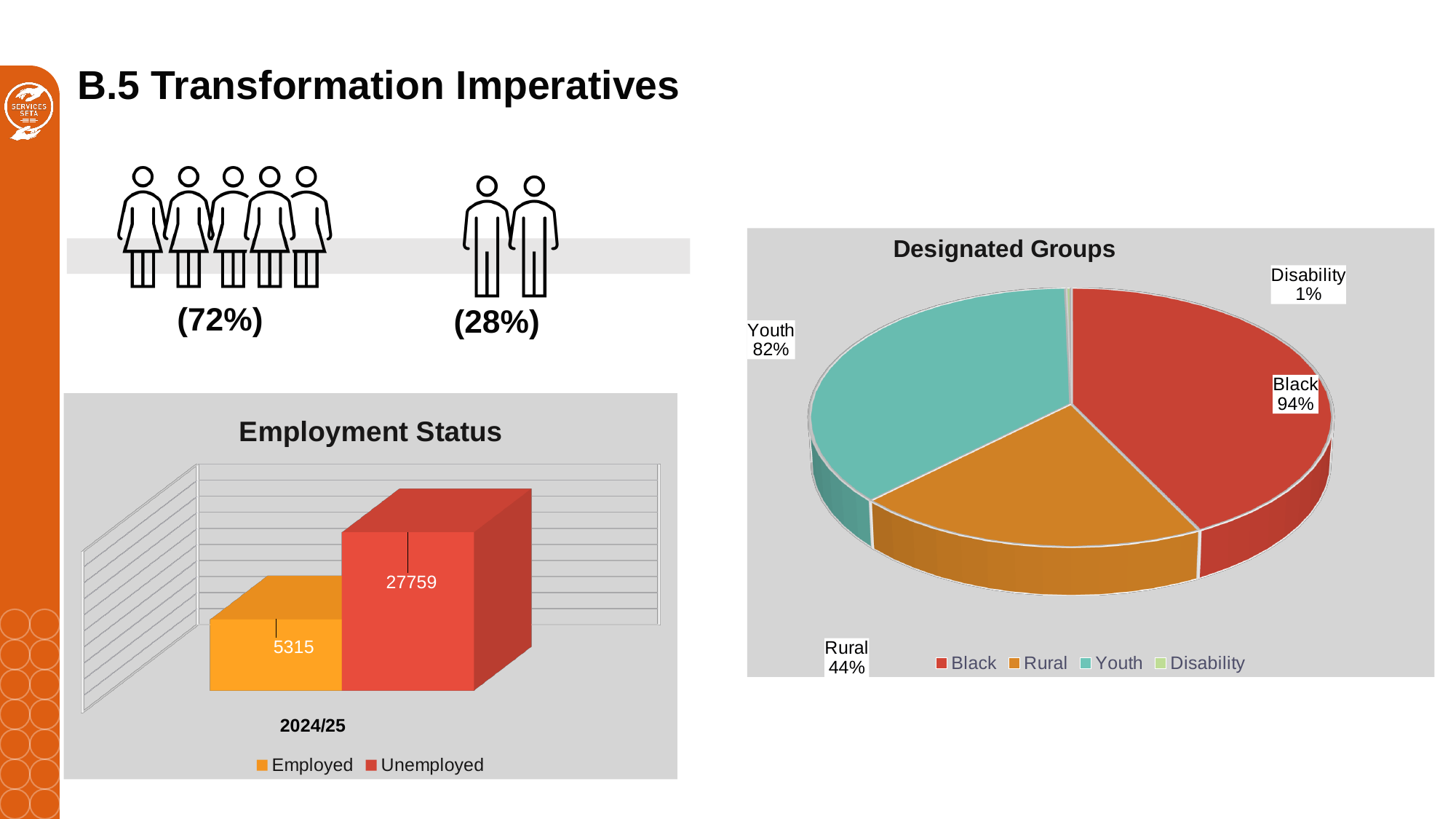
What kind of chart is the Designated Groups chart? Pie chart In the Employment Status chart, which series has the higher value, Employed or Unemployed? Unemployed In the Employment Status chart, what is the difference between the Unemployed and Employed values? 22444 In the Designated Groups chart, which group has the lowest percentage? Disability In the Employment Status chart, what is the value for Employed in 2024/25? 5315 How many categories does the legend of the Designated Groups chart list? 4 In the Designated Groups chart, what percentage is shown for Rural? 44% What kind of chart is the Employment Status chart? Bar chart In the Employment Status chart, what is the value for Unemployed in 2024/25? 27759 In the Designated Groups chart, what percentage is shown for Youth? 82% How many series does the legend of the Employment Status chart list? 2 In the Designated Groups chart, what percentage is shown for Black? 94%